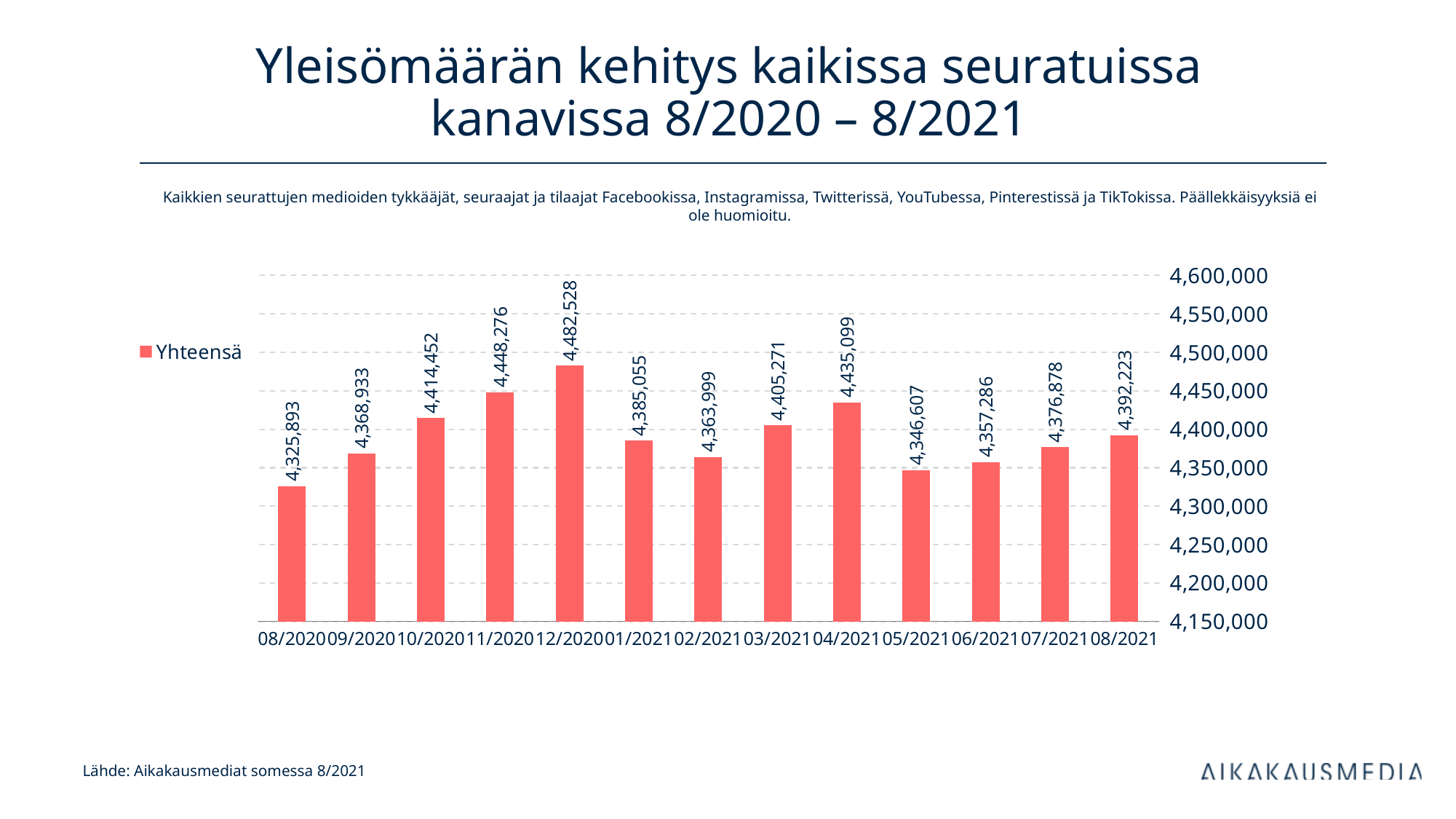
What kind of chart is shown on the slide? bar chart Which is larger, the value for 03/2021 or the value for 04/2021? 04/2021 What is the value for 08/2021? 4,392,223 Which month has the highest value? 12/2020 What is the value for 05/2021? 4,346,607 What is the value for 12/2020? 4,482,528 What is the difference between the values for 12/2020 and 01/2021? 97,473 How many series does the legend list? 1 Is the value for 08/2020 greater or less than 4,350,000? less What is the difference between the values for 08/2021 and 08/2020? 66,330 How many months are shown on the x axis? 13 Which month has the lowest value? 08/2020